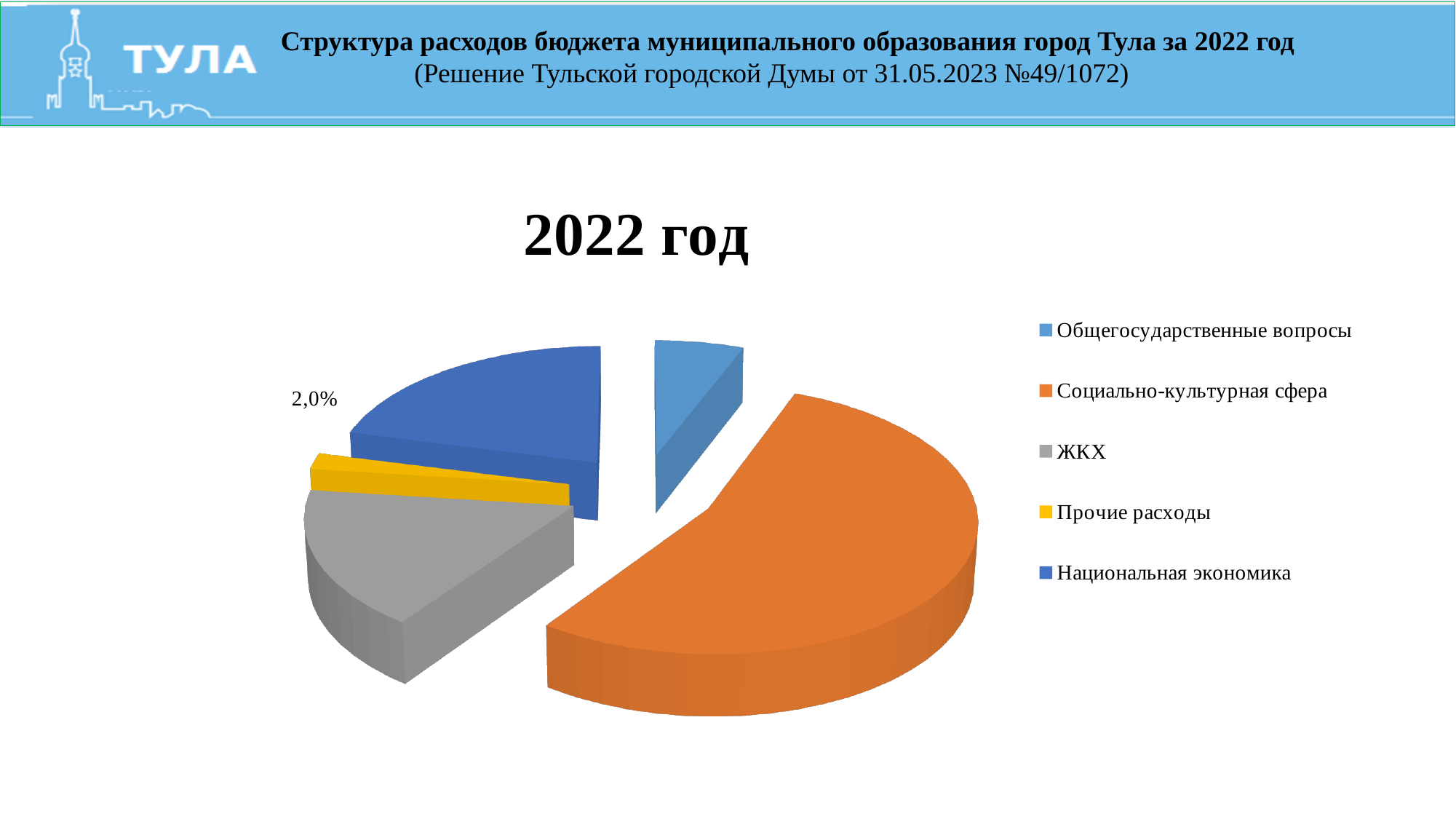
What share of the pie is labelled for Прочие расходы? 2,0% Which category is shown in orange on the pie chart? Социально-культурная сфера What kind of chart is shown on the slide? Pie chart Which category has the largest slice of the pie? Социально-культурная сфера How many categories does the pie chart's legend list? 5 What is the title of the chart? 2022 год Which slice is larger: Социально-культурная сфера or ЖКХ? Социально-культурная сфера Which slice is larger: ЖКХ or Общегосударственные вопросы? ЖКХ Which category has the smallest slice of the pie? Прочие расходы Which slice is larger: Национальная экономика or Прочие расходы? Национальная экономика Which is the only slice with a printed percentage label? Прочие расходы